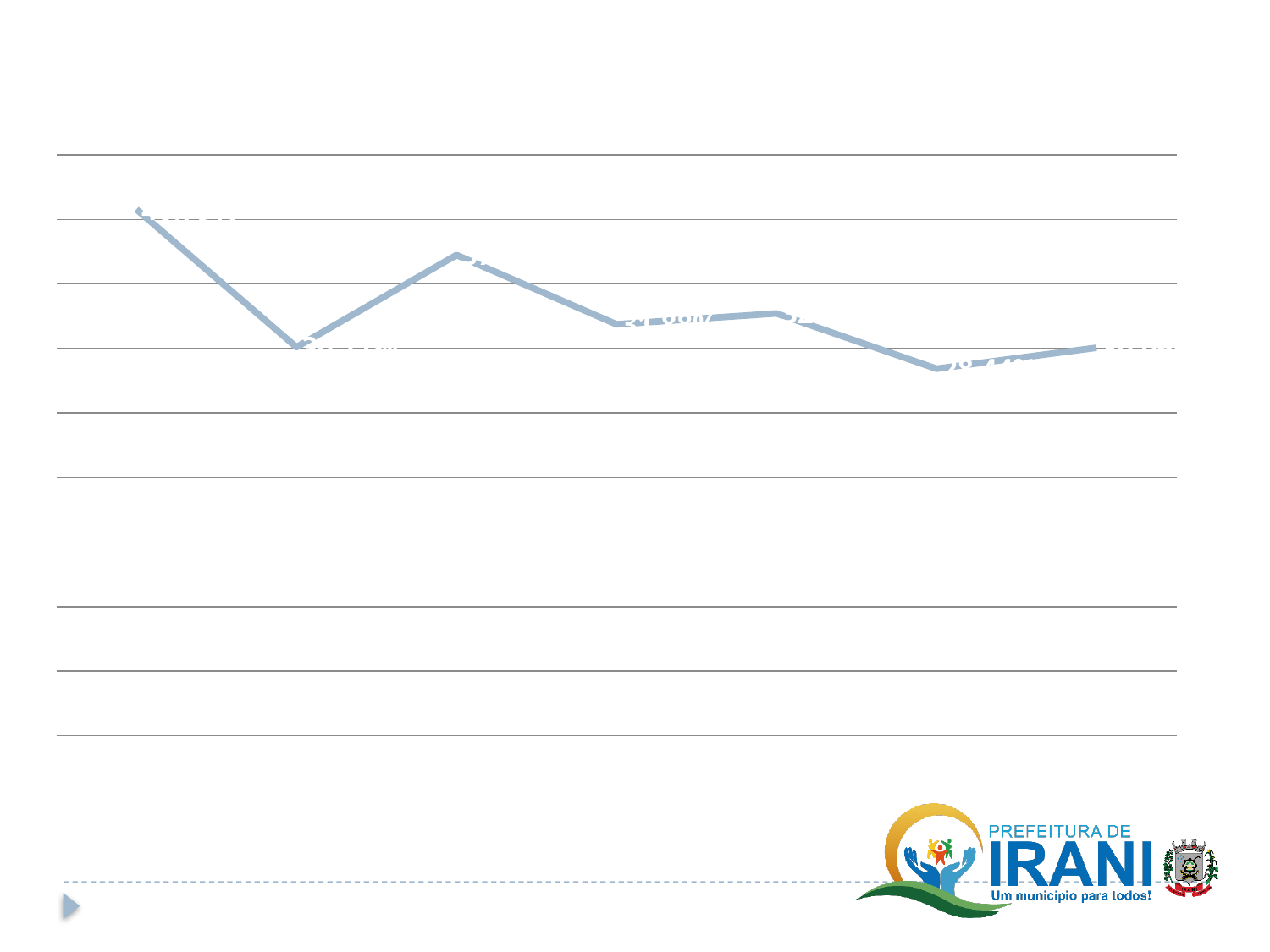
What kind of chart is shown on the slide? line chart Is the first plotted point higher or lower than the last plotted point? higher How many data points are plotted on the line? 7 Which plotted point is the lowest on the chart, by position from the left? the sixth point How many lines are plotted on the chart? 1 Overall, does the line fall or rise from its first point to its last point? fall Which plotted point is the highest on the chart, by position from the left? the first point